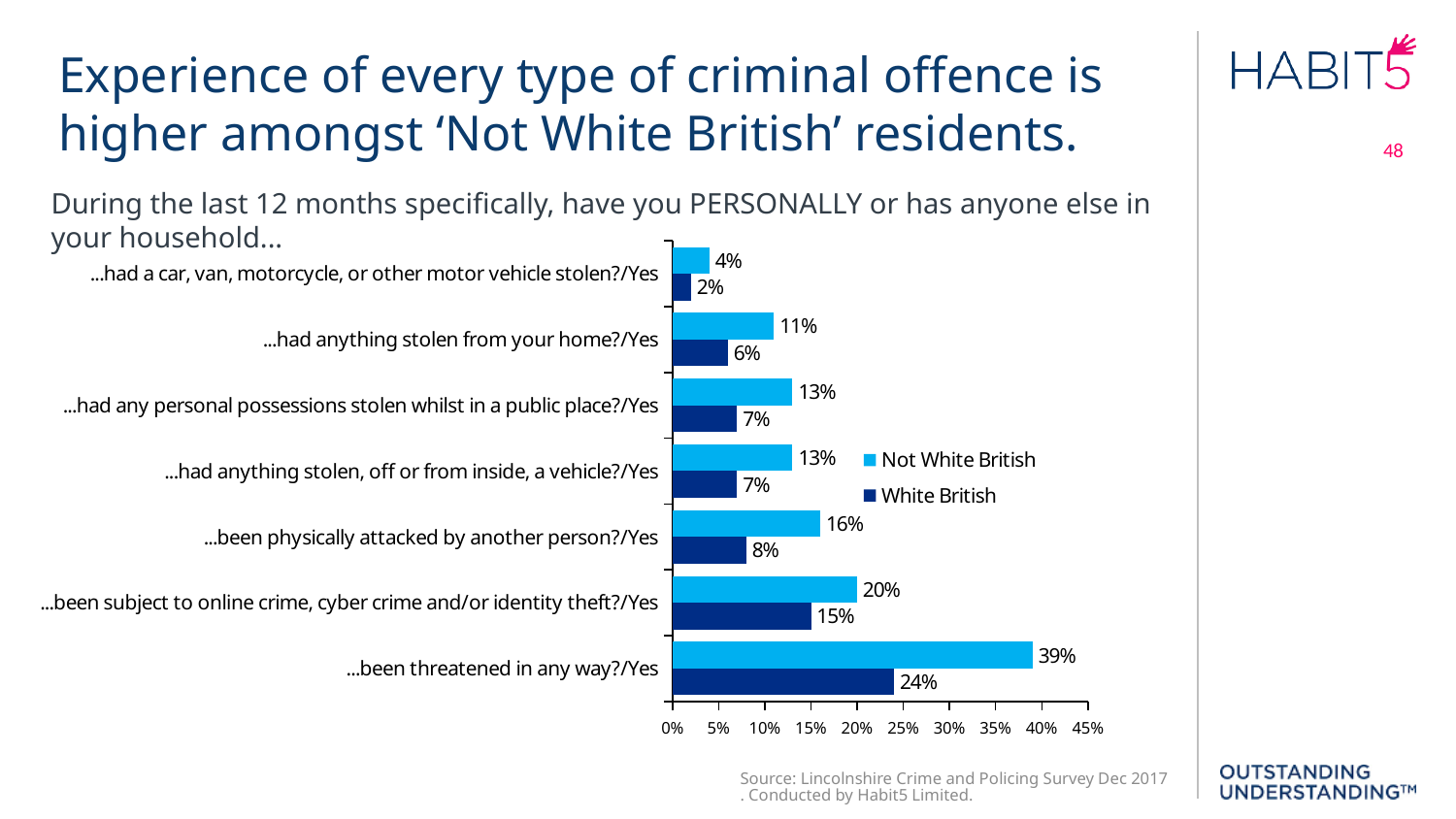
What percentage of 'White British' respondents said they had been subject to online crime, cyber crime and/or identity theft? 15% What percentage of 'White British' respondents said they had a car, van, motorcycle, or other motor vehicle stolen? 2% Which offence category has the lowest value for 'White British' respondents? ...had a car, van, motorcycle, or other motor vehicle stolen?/Yes What is the difference between the 'Not White British' and 'White British' values for being threatened in any way? 15% Which offence category has the highest value for 'Not White British' respondents? ...been threatened in any way?/Yes What kind of chart is shown on the slide? Bar chart How many series does the legend list? 2 Which group has the larger value for having anything stolen from your home: 'Not White British' or 'White British'? Not White British What percentage of 'Not White British' respondents said they had been threatened in any way? 39% Which series is shown in the darker blue colour? White British How many offence categories are shown in the chart? 7 What is the difference between the 'Not White British' and 'White British' values for being physically attacked by another person? 8%